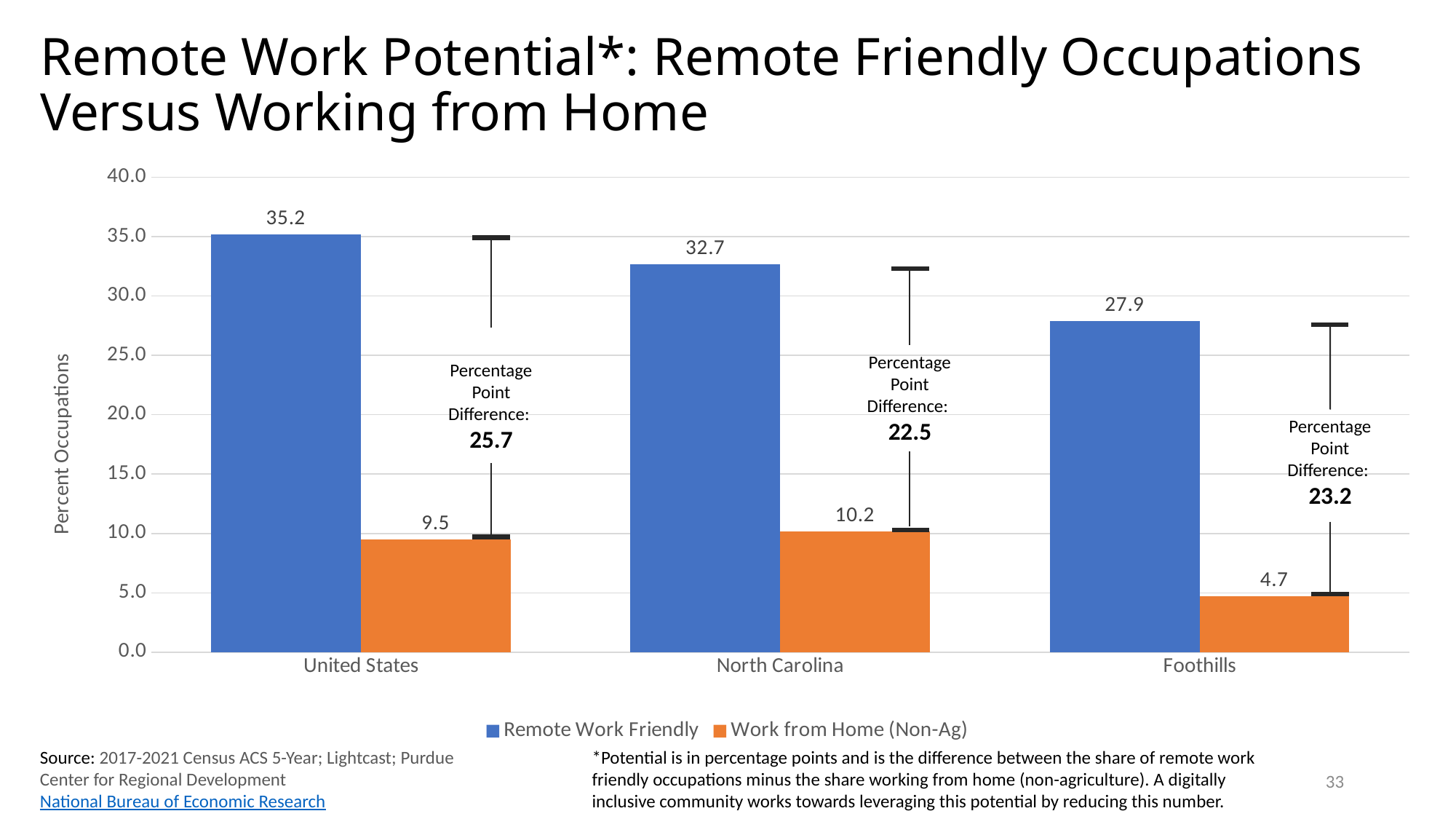
How many regions are shown on the x axis? 3 Which region has the lowest Work from Home (Non-Ag) value? Foothills How many series does the legend list? 2 Is the Remote Work Friendly value for Foothills greater or less than 30.0? less What is the difference between the Remote Work Friendly values for the United States and Foothills? 7.3 Which region has the highest Remote Work Friendly value? United States What is the Remote Work Friendly value for the United States? 35.2 What kind of chart is shown on the slide? bar chart What is the Work from Home (Non-Ag) value for North Carolina? 10.2 Which is larger: the Work from Home (Non-Ag) value for the United States or for North Carolina? North Carolina What is the percentage point difference shown for North Carolina? 22.5 What is the Work from Home (Non-Ag) value for Foothills? 4.7